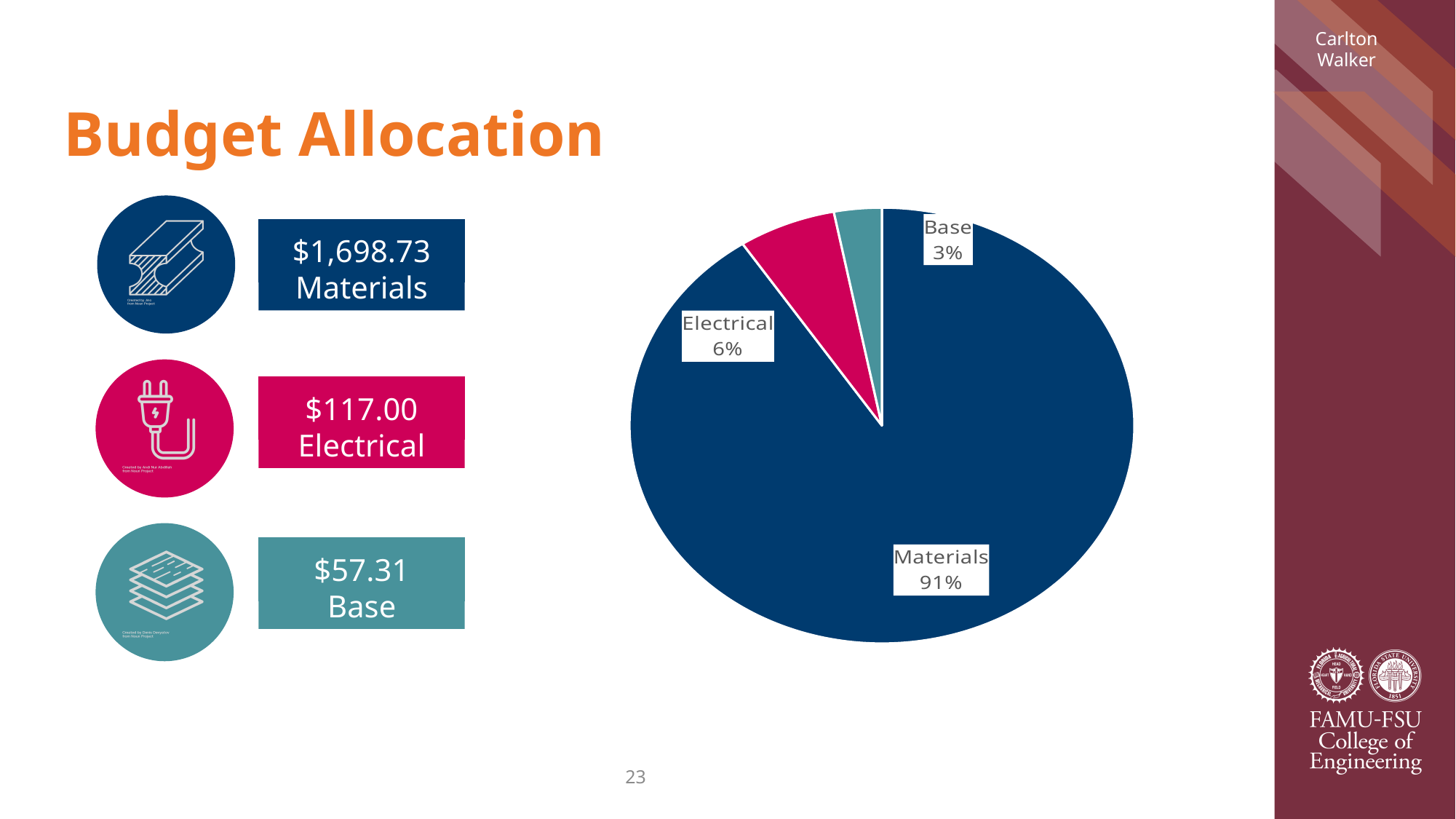
How many slices does the pie chart have? 3 Which category has the largest slice in the pie chart? Materials What share of the budget does Base account for in the pie chart? 3% Which category has the smallest slice in the pie chart? Base What share of the budget does Electrical account for in the pie chart? 6% What is the dollar amount shown for Base on the slide? $57.31 What is the dollar amount shown for Materials on the slide? $1,698.73 What type of chart is shown on the slide? Pie chart What colour is the Electrical slice in the pie chart? Magenta/red What is the difference in percentage points between the Materials and Electrical slices? 85 What share of the budget does Materials account for in the pie chart? 91% Which slice is larger, Electrical or Base? Electrical